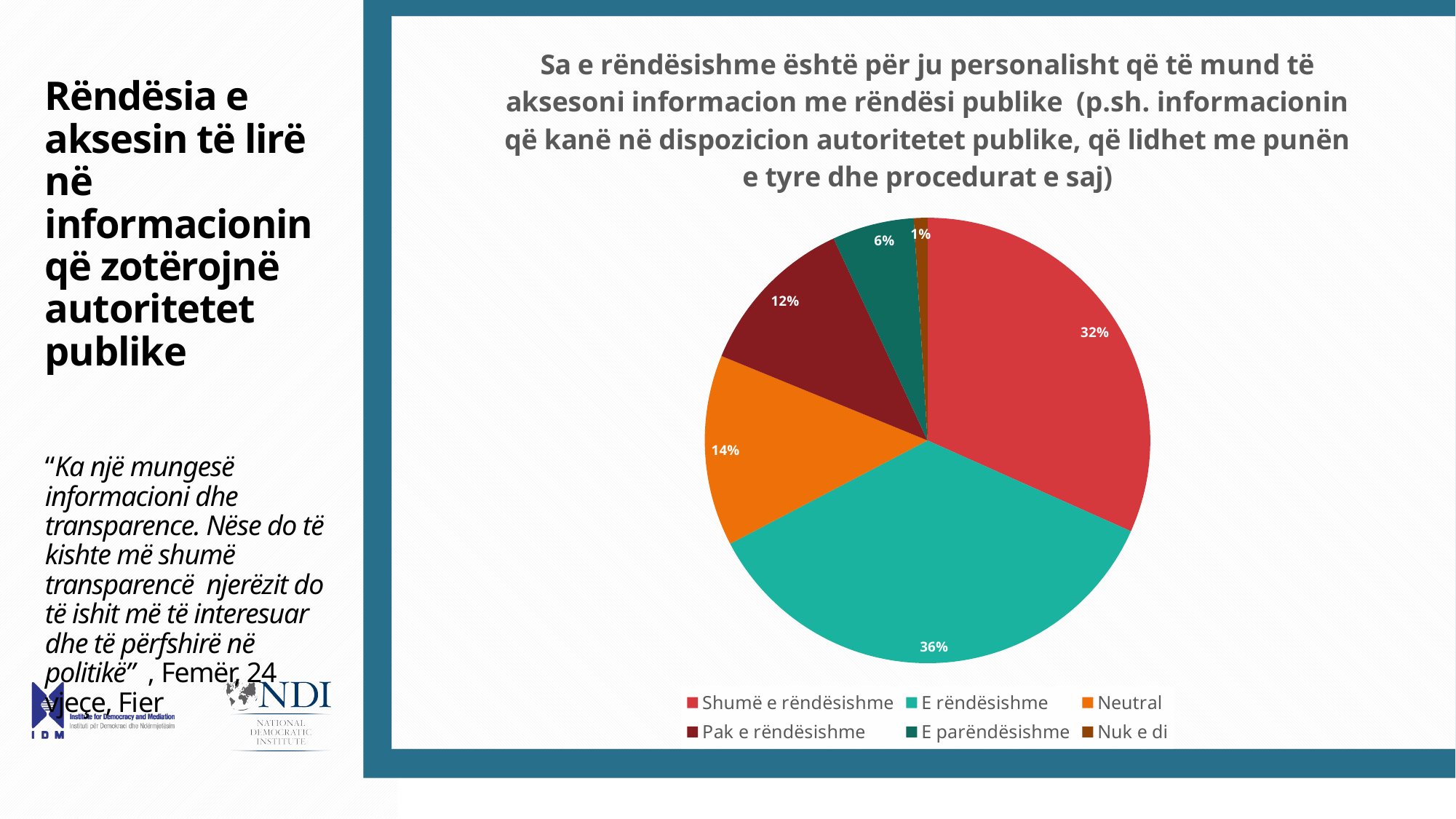
What share of respondents answered "Shumë e rëndësishme"? 32% What share of respondents answered "Nuk e di"? 1% Which category has the largest slice of the pie? E rëndësishme Which category has the smallest slice of the pie? Nuk e di What share of respondents answered "E rëndësishme"? 36% What is the difference between the shares for "E rëndësishme" and "Shumë e rëndësishme"? 4% What kind of chart is shown on the slide? pie chart Which is larger, the share for "Neutral" or the share for "Pak e rëndësishme"? Neutral How many categories does the legend list? 6 What share of respondents answered "Pak e rëndësishme"? 12% What share of respondents answered "Neutral"? 14% What colour is the slice for "E parëndësishme"? dark teal